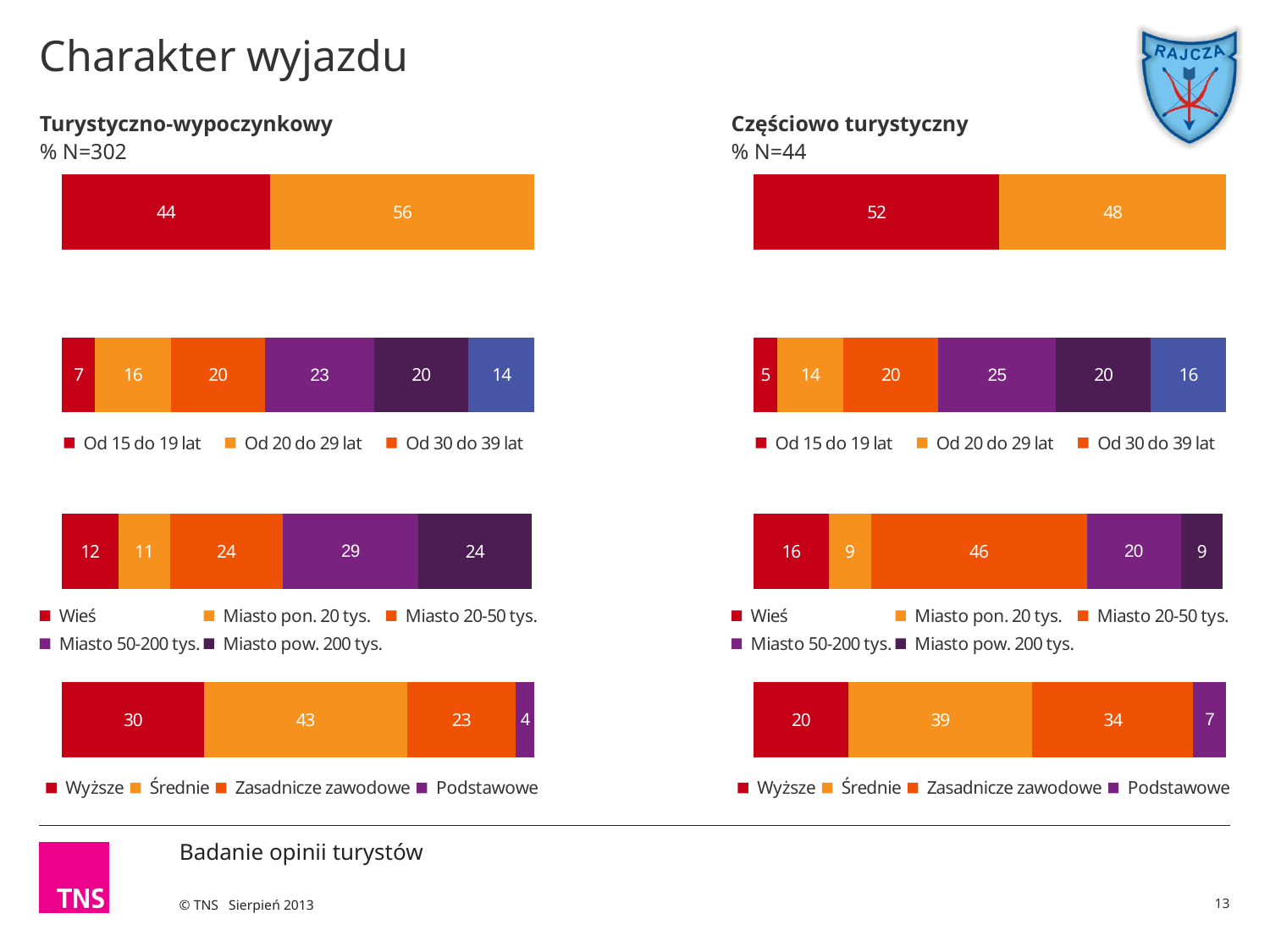
In the Turystyczno-wypoczynkowy column, in the age bar, what is the value for Od 15 do 19 lat? 7 In the Turystyczno-wypoczynkowy column, in the bottom bar (education), which category has the lowest value? Podstawowe In the Częściowo turystyczny column, in the bottom bar (education), what is the value for Podstawowe? 7 In the Częściowo turystyczny column, in the bar with the Wieś / Miasto legend, what is the value for Miasto 20-50 tys.? 46 In the Częściowo turystyczny column, in the bar with the Wieś / Miasto legend, which category has the highest value? Miasto 20-50 tys. What type of chart is used to show the data on this slide? Bar chart How many entries does the legend of the bottom (education) bar in the Turystyczno-wypoczynkowy column list? 4 In the Turystyczno-wypoczynkowy column, in the bottom bar (education), what is the difference between Średnie and Wyższe? 13 In the Turystyczno-wypoczynkowy column, in the bar with the Wieś / Miasto legend, what is the value for Miasto 50-200 tys.? 29 In the Częściowo turystyczny column, in the bottom bar (education), which is larger: Wyższe or Zasadnicze zawodowe? Zasadnicze zawodowe In the Turystyczno-wypoczynkowy column, in the bottom bar (education), what is the value for Średnie? 43 In the Częściowo turystyczny column, in the age bar, what is the value for Od 30 do 39 lat? 20